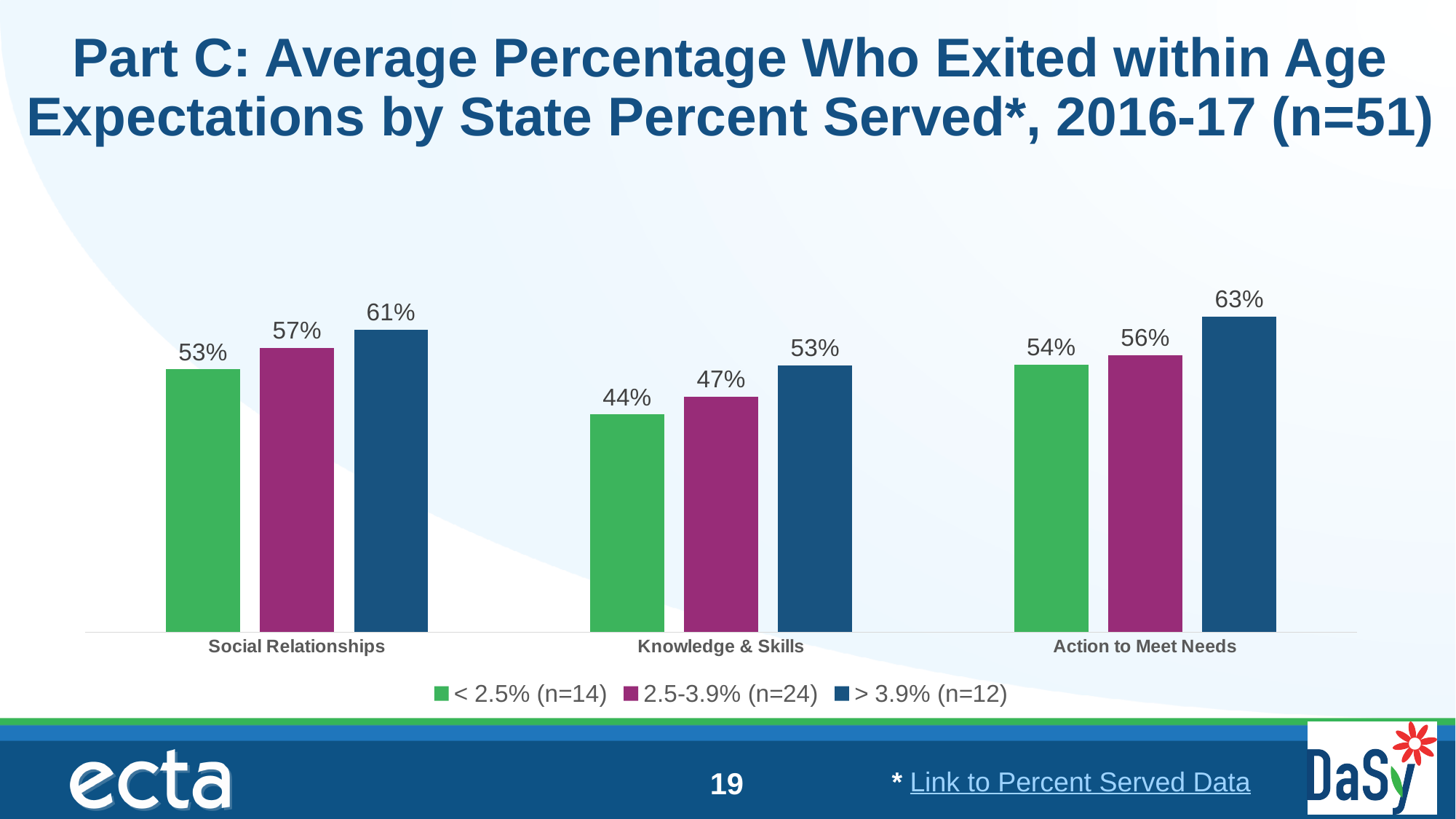
How many series does the legend list? 3 Within each category, do the values rise or fall from the < 2.5% series to the > 3.9% series? Rise In the Social Relationships category, which series has the larger value: < 2.5% (n=14) or > 3.9% (n=12)? > 3.9% (n=12) What is the difference between the > 3.9% (n=12) and < 2.5% (n=14) values in the Knowledge & Skills category? 9% Which category has the lowest value for the < 2.5% (n=14) series? Knowledge & Skills What kind of chart is shown on the slide? Bar chart Which colour represents the 2.5-3.9% (n=24) series? Purple Which category has the highest value for the > 3.9% (n=12) series? Action to Meet Needs How many categories are shown on the x axis? 3 What is the value for the 2.5-3.9% (n=24) series in the Social Relationships category? 57% What is the value for the > 3.9% (n=12) series in the Action to Meet Needs category? 63% What is the value for the < 2.5% (n=14) series in the Knowledge & Skills category? 44%